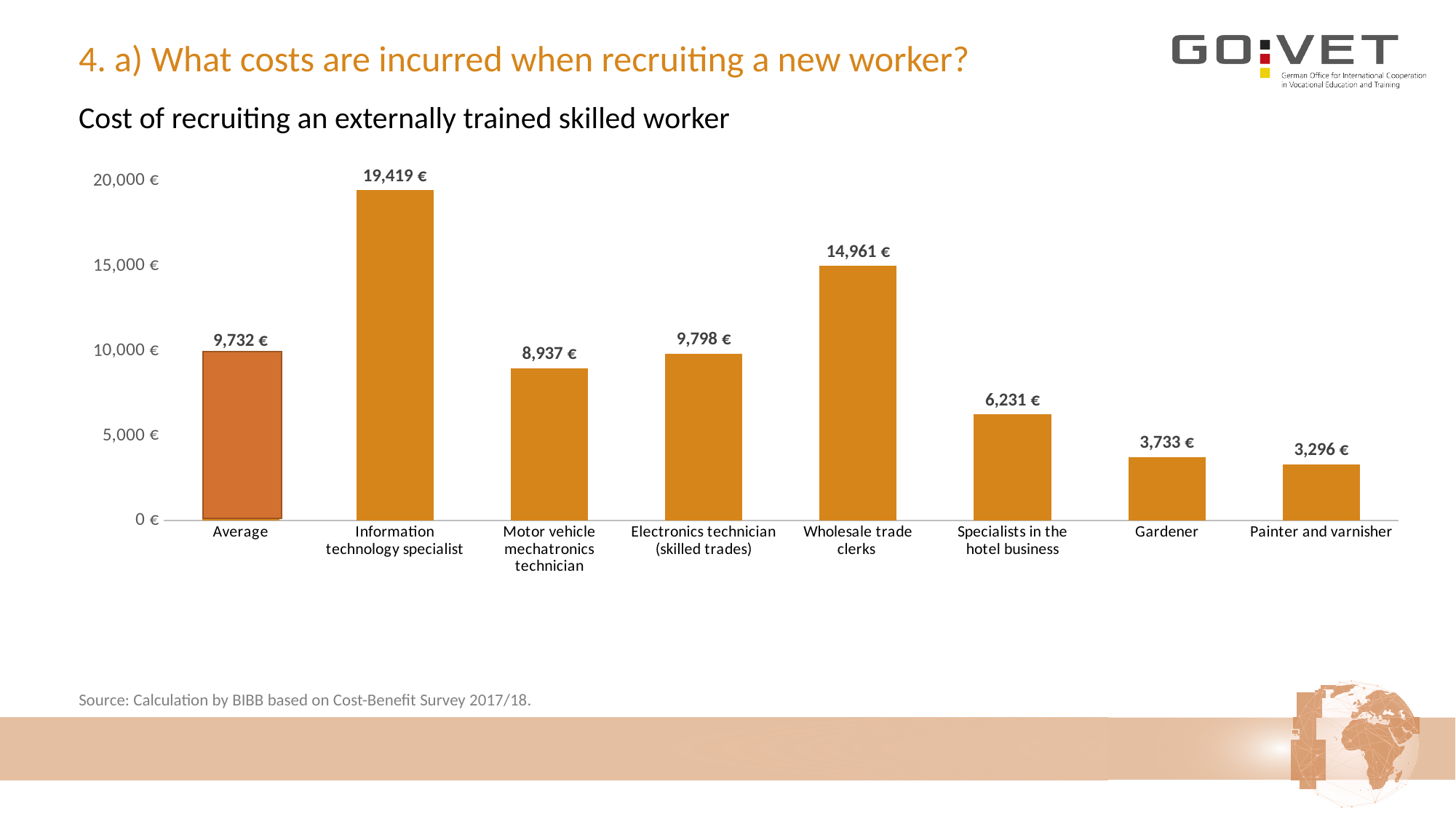
What is the cost of recruiting an externally trained Information technology specialist? 19,419 € What is the recruiting cost shown for Gardener? 3,733 € What kind of chart is shown on the slide? Bar chart Which bar is shown in a different colour from the others? Average What is the title of the chart? Cost of recruiting an externally trained skilled worker What is the difference between the recruiting cost for Wholesale trade clerks and for Specialists in the hotel business? 8,730 € Is the recruiting cost for Wholesale trade clerks greater or less than 10,000 €? greater Which occupation has the highest recruiting cost? Information technology specialist Which has a higher recruiting cost: Motor vehicle mechatronics technician or Electronics technician (skilled trades)? Electronics technician (skilled trades) Which occupation has the lowest recruiting cost? Painter and varnisher How many categories are shown on the x axis of the chart? 8 What is the average cost of recruiting an externally trained skilled worker? 9,732 €